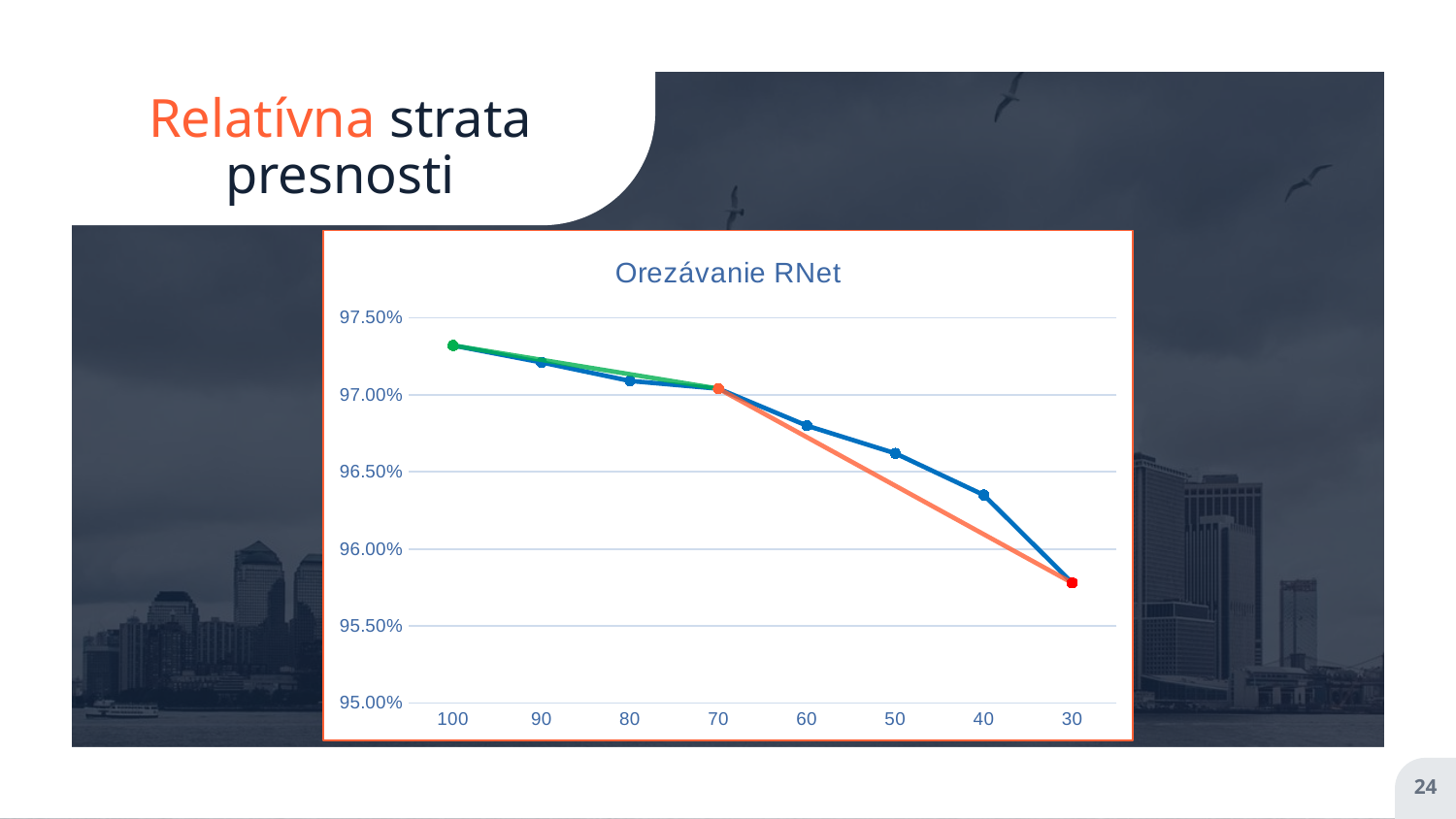
Do the values rise or fall as you move from 100 to 30 along the x axis? fall Is the value at x = 100 greater or less than 97.00%? greater What kind of chart is shown on the slide? line chart Is the value at x = 30 greater or less than 96.00%? less At which x-axis value is the blue line lowest? 30 At which x-axis value is the blue line highest? 100 Which has the larger value on the blue line, x = 60 or x = 40? 60 What is the title of the chart? Orezávanie RNet Is the value at x = 40 greater or less than 96.50%? less How many points are plotted along the x axis of the blue line? 8 What is the lowest value shown on the y axis? 95.00%